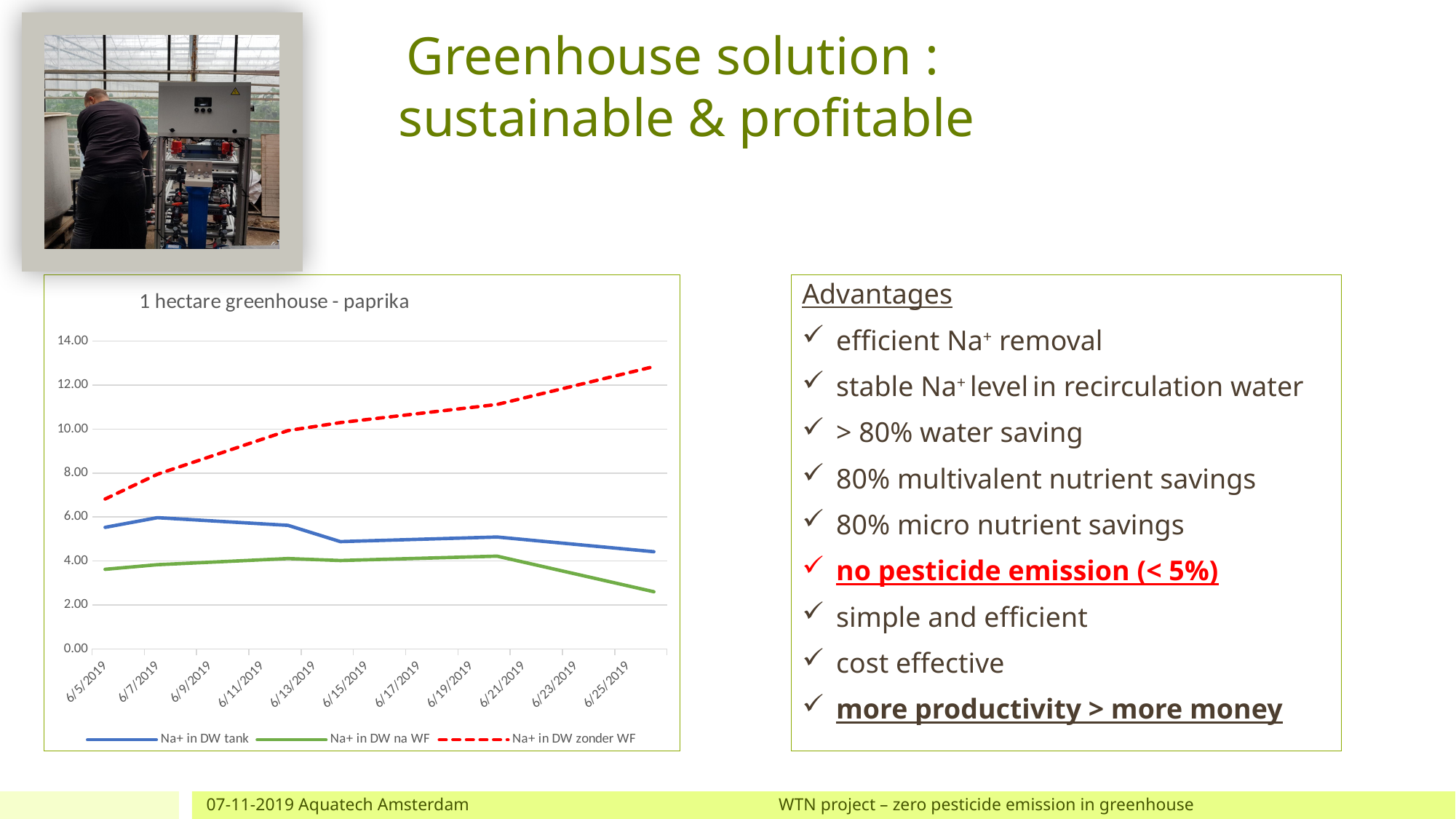
Is the value for Na+ in DW na WF at 6/25/2019 greater or less than 4.00? less Which series has the lowest value at 6/25/2019? Na+ in DW na WF How many series does the chart legend list? 3 What kind of chart is shown on the slide? line chart Which series is drawn as a red dashed line? Na+ in DW zonder WF Is the value for Na+ in DW zonder WF at 6/25/2019 greater or less than 12.00? greater Is the value for Na+ in DW zonder WF at 6/5/2019 greater or less than 8.00? less Does the value for Na+ in DW na WF rise or fall between 6/21/2019 and 6/25/2019? fall Which series has the highest value at 6/25/2019? Na+ in DW zonder WF Does the value for Na+ in DW zonder WF rise or fall from 6/5/2019 to 6/25/2019? rise What is the title of the chart? 1 hectare greenhouse - paprika